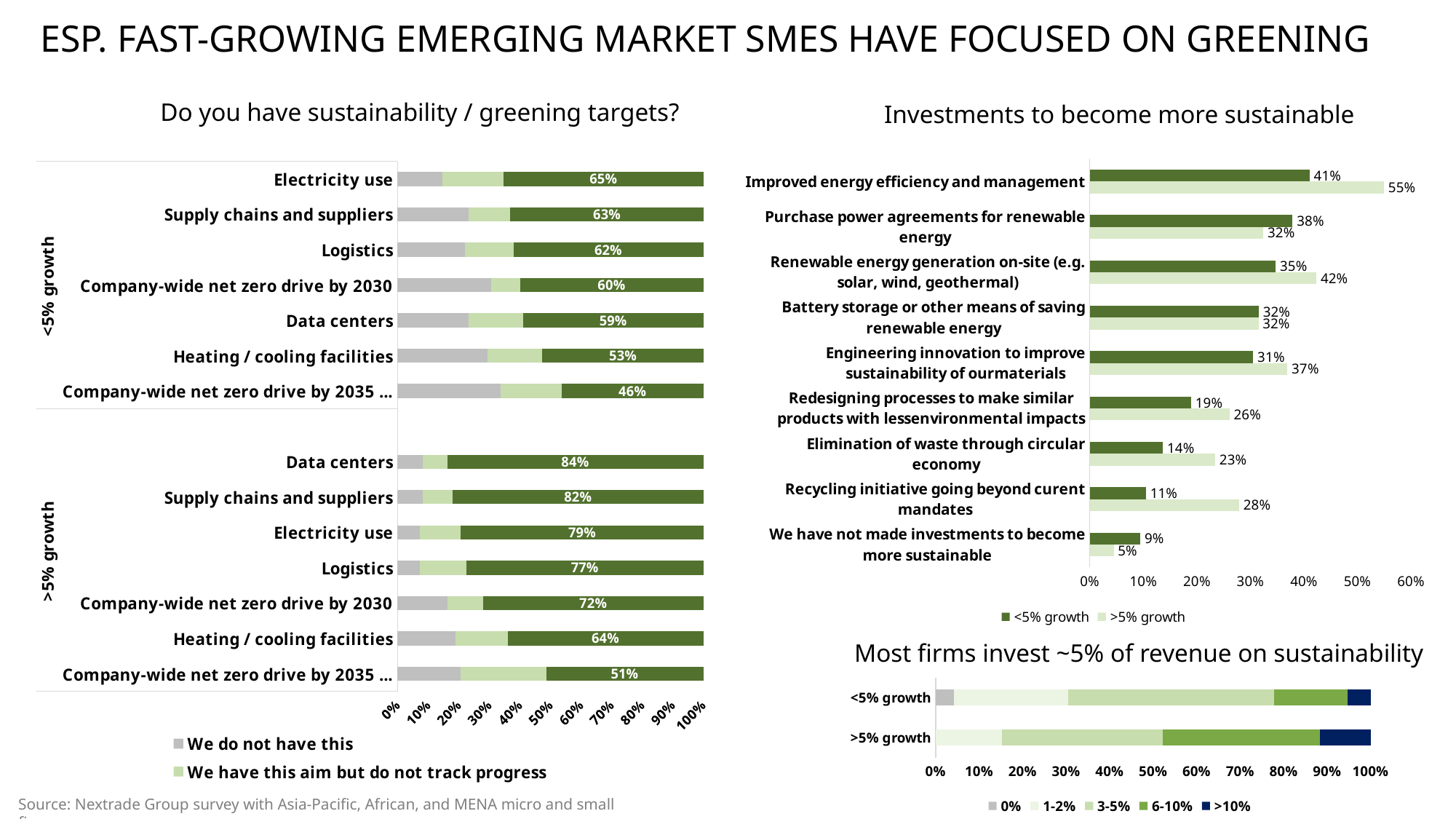
In the 'Investments to become more sustainable' chart, which category has the lowest '<5% growth' value? We have not made investments to become more sustainable How many series does the legend of the 'Investments to become more sustainable' chart list? 2 How many categories are shown in the 'Investments to become more sustainable' chart? 9 In the 'Investments to become more sustainable' chart, which category has the highest '>5% growth' value? Improved energy efficiency and management How many series does the legend of the 'Most firms invest ~5% of revenue on sustainability' chart list? 5 In the 'Do you have sustainability / greening targets?' chart, what is the labeled value for 'Data centers' in the '>5% growth' group? 84% In the 'Investments to become more sustainable' chart, what is the value for '>5% growth' for 'Recycling initiative going beyond curent mandates'? 28% In the 'Investments to become more sustainable' chart, what is the difference between the '>5% growth' and '<5% growth' values for 'Elimination of waste through circular economy'? 9% In the 'Investments to become more sustainable' chart, for 'Purchase power agreements for renewable energy', which series has the larger value: '<5% growth' or '>5% growth'? <5% growth In the 'Investments to become more sustainable' chart, what is the value for '<5% growth' for 'Improved energy efficiency and management'? 41% In the 'Do you have sustainability / greening targets?' chart, what is the difference between the labeled values for 'Electricity use' in the '>5% growth' group and the '<5% growth' group? 14% In the 'Do you have sustainability / greening targets?' chart, which category in the '<5% growth' group has the lowest labeled value? Company-wide net zero drive by 2035 ...